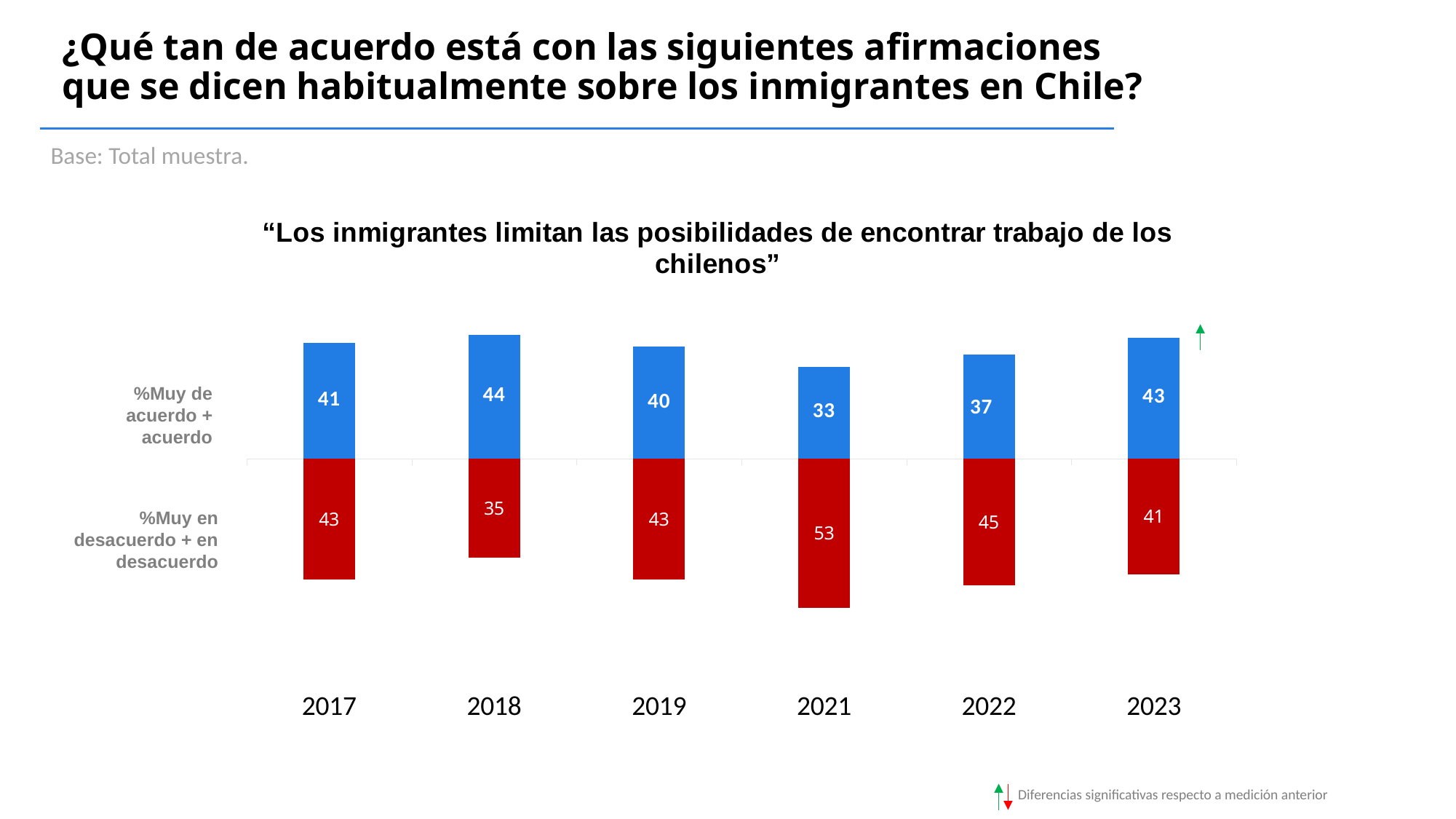
In which year is the "%Muy de acuerdo + acuerdo" value lowest? 2021 In which year is the "%Muy en desacuerdo + en desacuerdo" value highest? 2021 What is the difference between the "%Muy en desacuerdo + en desacuerdo" value in 2021 and in 2022? 8 How many years are shown on the x axis? 6 Which is larger in 2019: the "%Muy de acuerdo + acuerdo" value or the "%Muy en desacuerdo + en desacuerdo" value? %Muy en desacuerdo + en desacuerdo In which year is the "%Muy de acuerdo + acuerdo" value highest? 2018 What is the value for "%Muy en desacuerdo + en desacuerdo" in 2018? 35 What is the value for "%Muy de acuerdo + acuerdo" in 2021? 33 What is the title of the chart? "Los inmigrantes limitan las posibilidades de encontrar trabajo de los chilenos" What kind of chart is shown on the slide? Bar chart How many series does the chart show? 2 What is the value for "%Muy de acuerdo + acuerdo" in 2023? 43